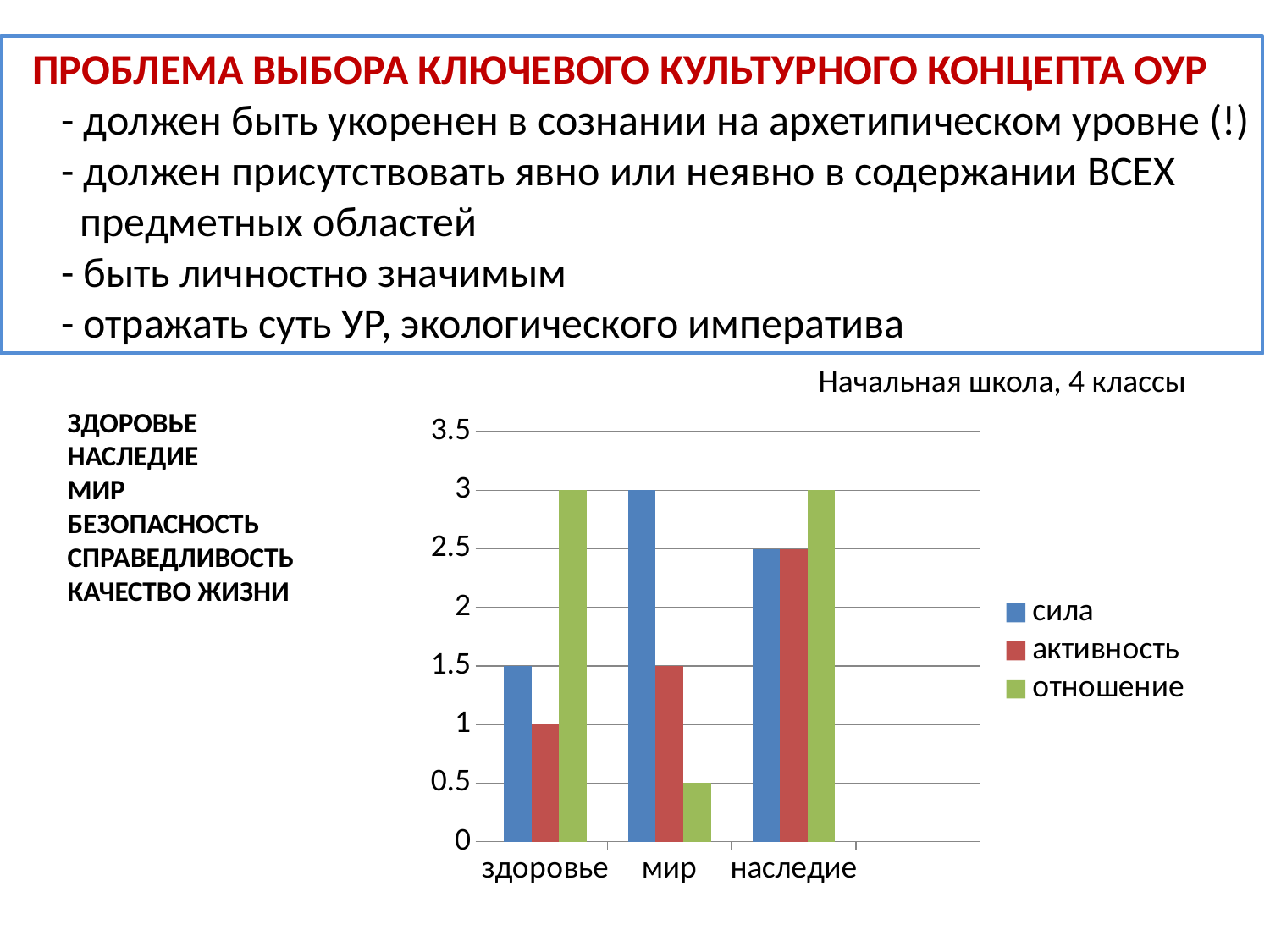
How many categories are shown on the x axis of the chart? 3 What is the difference between отношение and активность for здоровье? 2 Which category has the highest value for сила? мир What is the value of сила for здоровье? 1.5 What is the value of активность for наследие? 2.5 What kind of chart is shown on the slide? bar chart How many series does the chart legend list? 3 What is the value of отношение for мир? 0.5 Which category has the lowest value for отношение? мир Is the value of активность for здоровье greater or less than 2? less Which is larger for мир: сила or активность? сила What is the text shown above the chart describing the group surveyed? Начальная школа, 4 классы